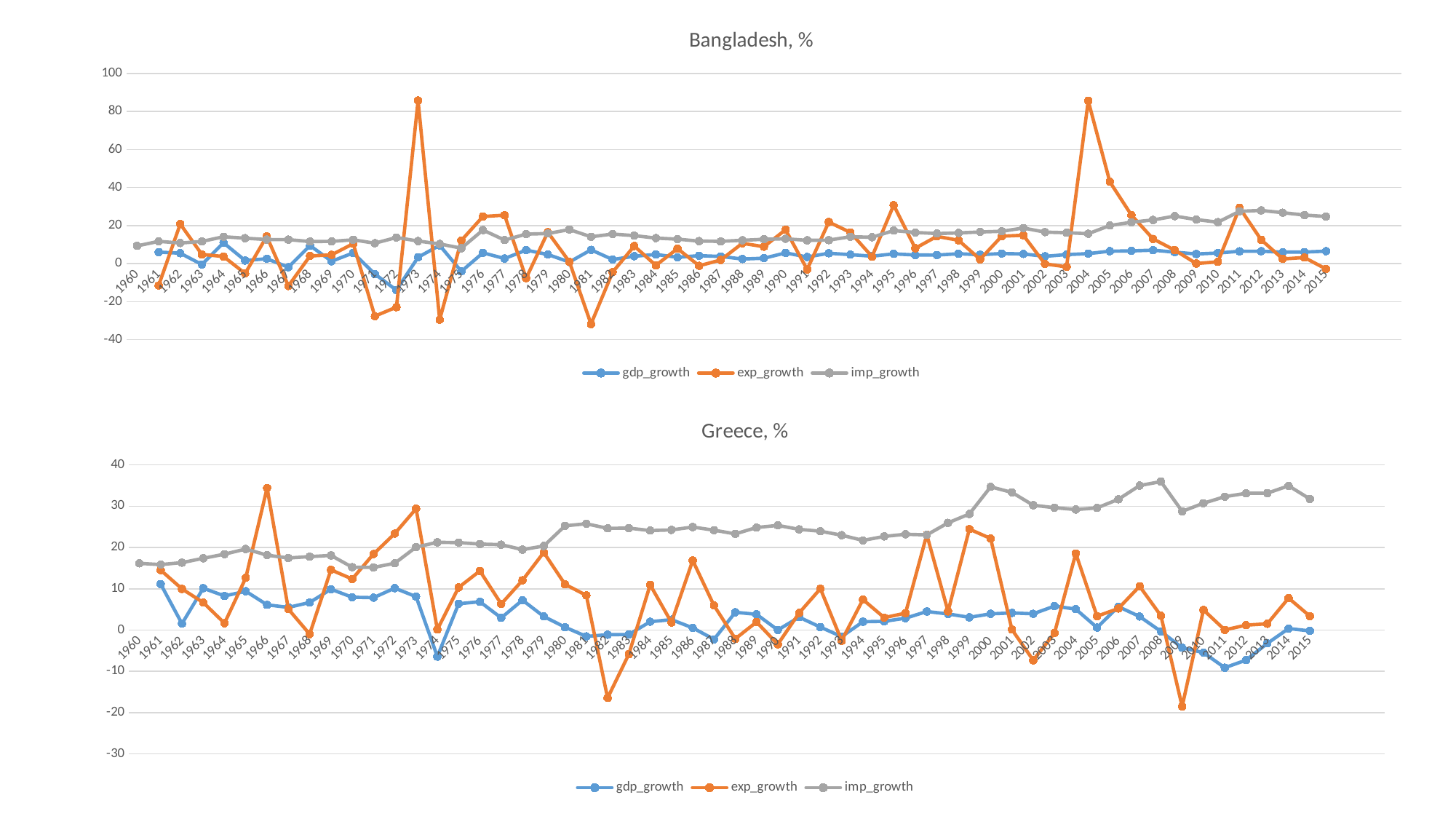
In the Bangladesh, % chart, is the exp_growth value for 1973 greater or less than 80? greater What kind of chart is the Bangladesh, % chart? line chart In the Bangladesh, % chart, is the imp_growth value for 2015 greater or less than 20? greater In the Bangladesh, % chart, is the exp_growth value for 2005 greater or less than 20? greater How many years are plotted along the x axis of the Bangladesh, % chart? 56 In the Greece, % chart, which year has the highest exp_growth value? 1966 In the Greece, % chart, which year has the lowest gdp_growth value? 2011 How many series does the legend of the Greece, % chart list? 3 In the Greece, % chart, does the imp_growth series generally rise or fall from 1960 to 2015? rise In the Greece, % chart, which series has the larger value in 2015, imp_growth or exp_growth? imp_growth